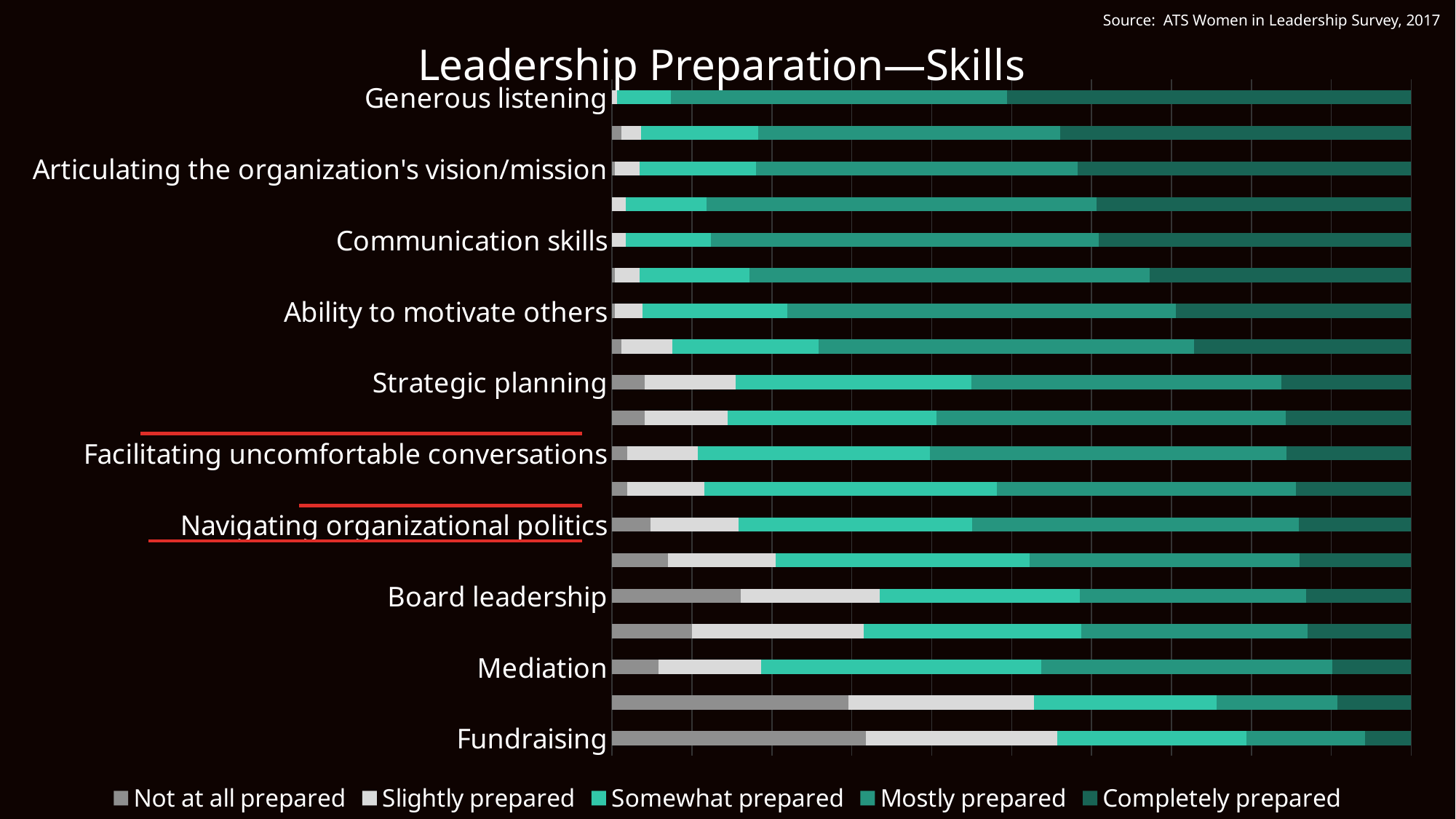
Which labeled skill has the largest 'Completely prepared' segment? Generous listening Is the 'Somewhat prepared' segment larger for Fundraising or for Generous listening? Fundraising How many bars are plotted in the chart? 19 Is the 'Not at all prepared' segment larger for Board leadership or for Generous listening? Board leadership Which labeled skill has the largest 'Not at all prepared' segment? Fundraising How many series does the legend list? 5 Which labeled skill has the smallest 'Completely prepared' segment? Fundraising What type of chart is shown on the slide? Stacked bar chart What is the title of the chart? Leadership Preparation—Skills Moving down the chart from Generous listening to Fundraising, do the 'Not at all prepared' segments generally get larger or smaller? Larger What source is cited for the chart data? ATS Women in Leadership Survey, 2017